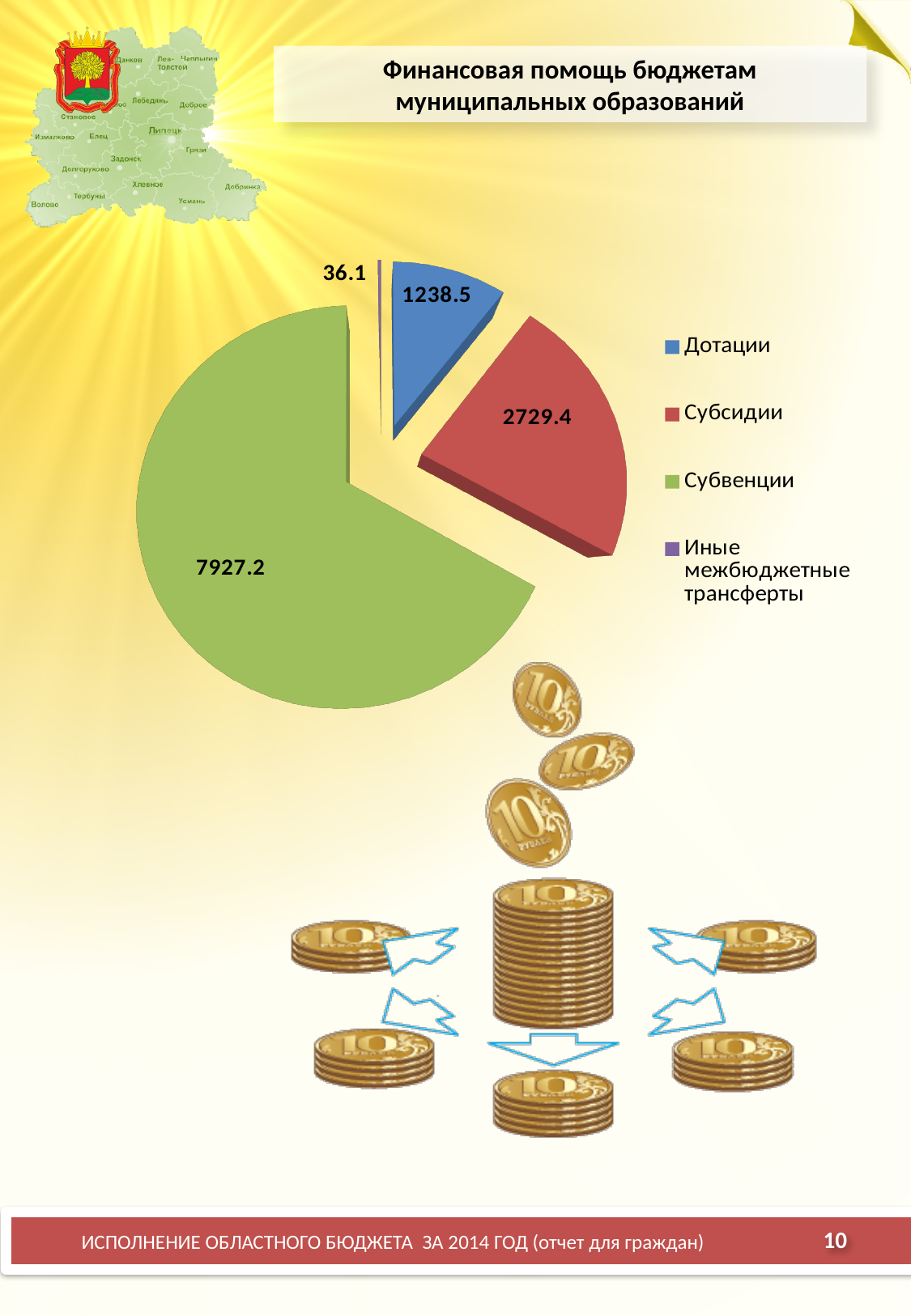
What is the difference between the values for Субвенции and Субсидии? 5197.8 Which category has the smallest slice in the pie chart? Иные межбюджетные трансферты What is the value for Иные межбюджетные трансферты in the pie chart? 36.1 What is the value for Субвенции in the pie chart? 7927.2 What kind of chart is shown on the slide? pie chart What is the value for Дотации in the pie chart? 1238.5 What is the value for Субсидии in the pie chart? 2729.4 Which is larger, the value for Дотации or the value for Субсидии? Субсидии What is the difference between the values for Субсидии and Дотации? 1490.9 Which category has the largest slice in the pie chart? Субвенции What is the title of the chart on the slide? Финансовая помощь бюджетам муниципальных образований How many categories does the pie chart show? 4